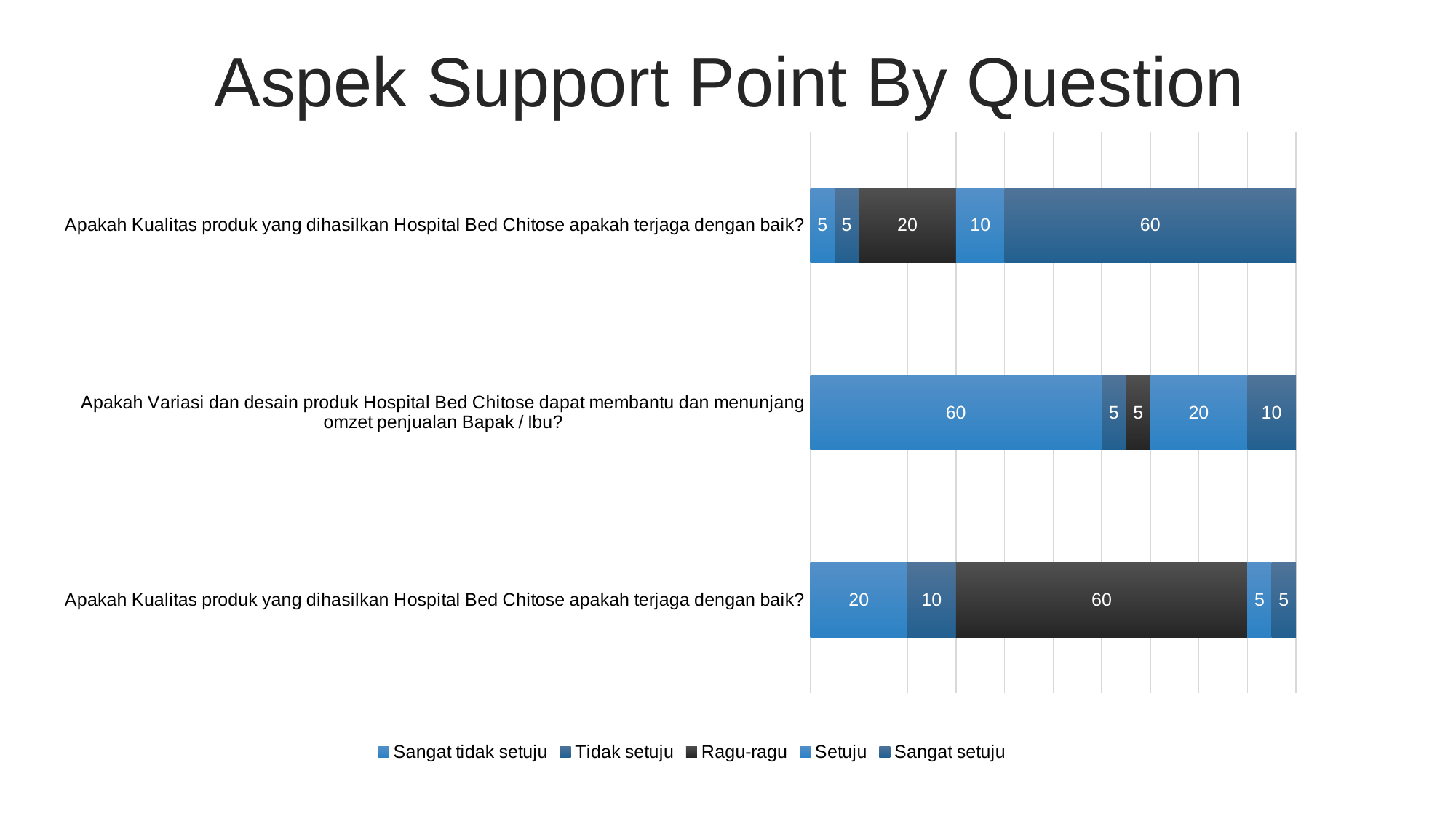
In the bottom bar of the chart, what is the value for Ragu-ragu? 60 What is the title of the chart? Aspek Support Point By Question For the question 'Apakah Variasi dan desain produk Hospital Bed Chitose dapat membantu dan menunjang omzet penjualan Bapak / Ibu?', what is the value for Sangat setuju? 10 For the question 'Apakah Variasi dan desain produk Hospital Bed Chitose dapat membantu dan menunjang omzet penjualan Bapak / Ibu?', what is the value for Setuju? 20 How many series does the legend list? 5 In the top bar of the chart, what is the value for Sangat setuju? 60 For the question 'Apakah Variasi dan desain produk Hospital Bed Chitose dapat membantu dan menunjang omzet penjualan Bapak / Ibu?', what is the difference between the Sangat tidak setuju value and the Setuju value? 40 How many question categories (bars) are plotted in the chart? 3 What is the total of the stacked bar for 'Apakah Variasi dan desain produk Hospital Bed Chitose dapat membantu dan menunjang omzet penjualan Bapak / Ibu?'? 100 For the question 'Apakah Variasi dan desain produk Hospital Bed Chitose dapat membantu dan menunjang omzet penjualan Bapak / Ibu?', what is the value for Sangat tidak setuju? 60 For the question 'Apakah Variasi dan desain produk Hospital Bed Chitose dapat membantu dan menunjang omzet penjualan Bapak / Ibu?', which response has the largest value? Sangat tidak setuju What kind of chart is shown on the slide? Stacked bar chart